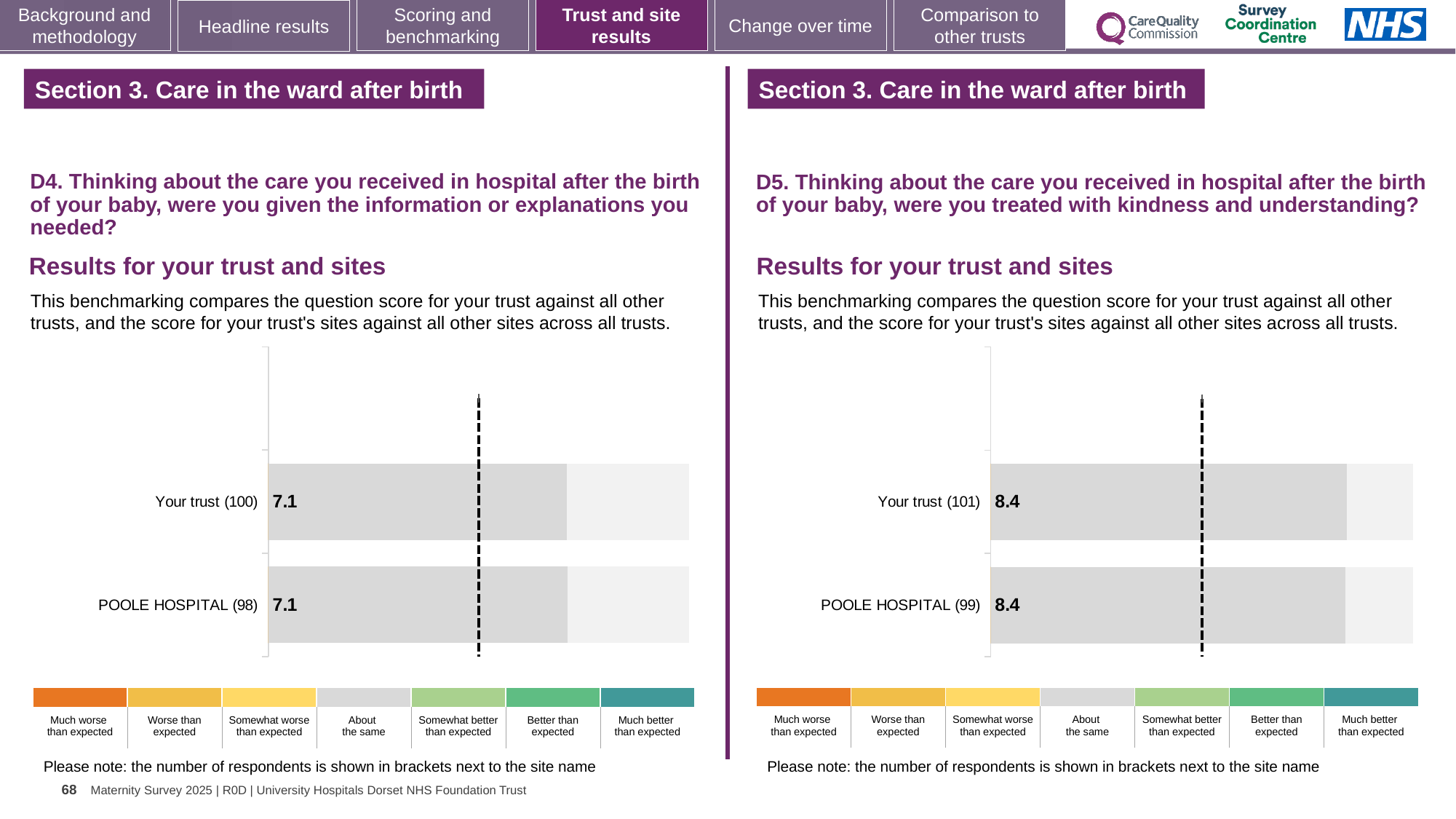
In the D4 chart on the left, what is the score for POOLE HOSPITAL? 7.1 In the D5 chart on the right, what is the score for POOLE HOSPITAL? 8.4 What kind of chart is the D4 chart on the left? Bar chart In the D4 chart on the left, what is the difference between the score for Your trust and the score for POOLE HOSPITAL? 0.0 In the D4 chart on the left, what is the score for Your trust? 7.1 In the D5 chart on the right, what is the score for Your trust? 8.4 In the D5 chart on the right, how many respondents are shown in brackets for Your trust? 101 Is the score for Your trust in the D5 chart on the right larger or smaller than the score for Your trust in the D4 chart on the left? Larger In the D4 chart on the left, how many respondents are shown in brackets for POOLE HOSPITAL? 98 In the D4 chart on the left, how many bars are plotted? 2 In the D5 chart on the right, how many bars are plotted? 2